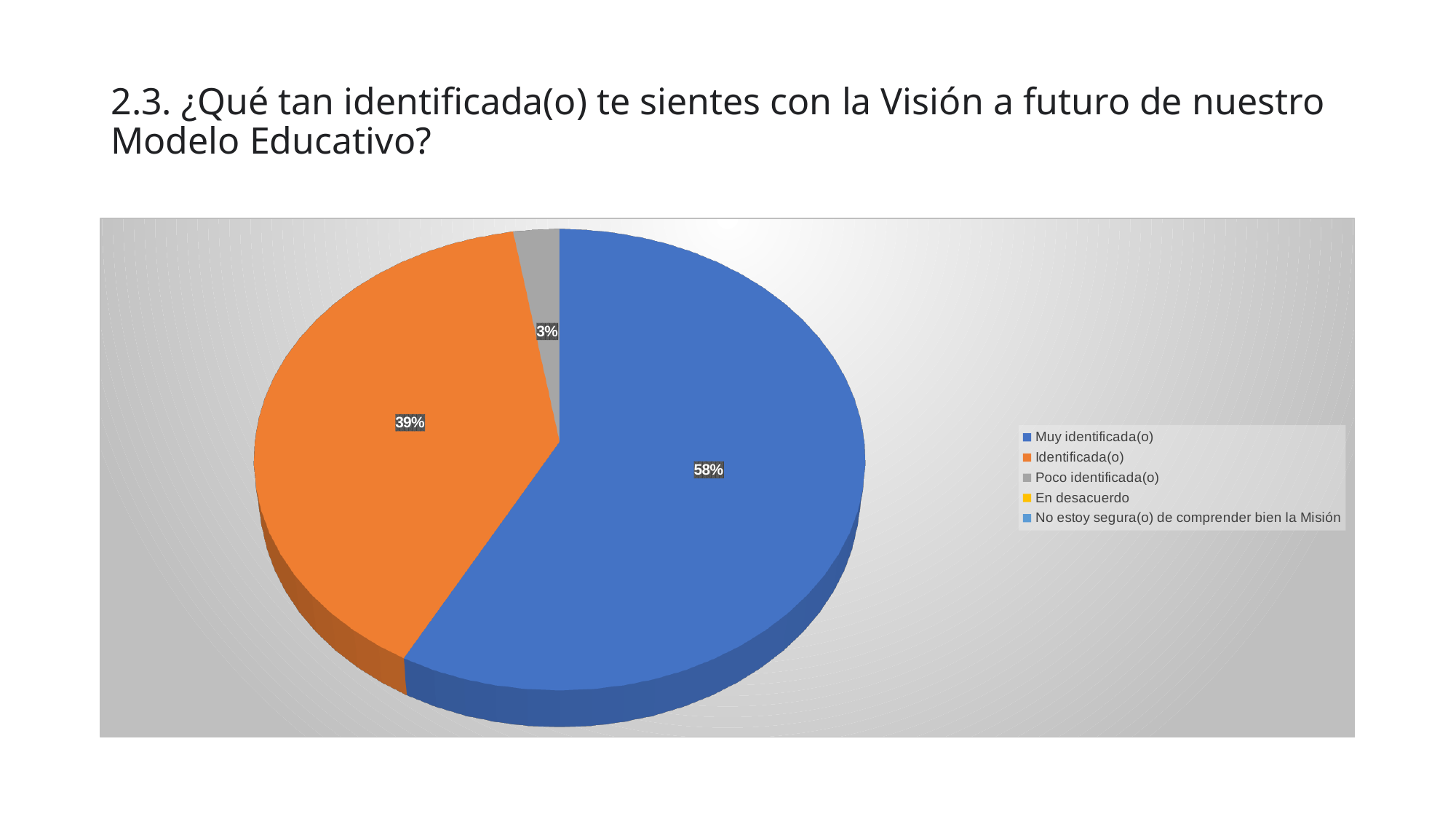
What is the combined share of "Muy identificada(o)" and "Identificada(o)"? 97% What kind of chart is shown on the slide? pie chart Which of the labelled slices is the smallest? Poco identificada(o) What share of the pie does "Identificada(o)" have? 39% What colour is the slice for "Identificada(o)"? orange Which category has the largest slice of the pie? Muy identificada(o) How many entries does the legend list? 5 What share of the pie does "Muy identificada(o)" have? 58% What share of the pie does "Poco identificada(o)" have? 3% What is the difference in percentage points between "Muy identificada(o)" and "Identificada(o)"? 19 Which is larger, the slice for "Identificada(o)" or the slice for "Poco identificada(o)"? Identificada(o) Which legend entry is shown in yellow? En desacuerdo